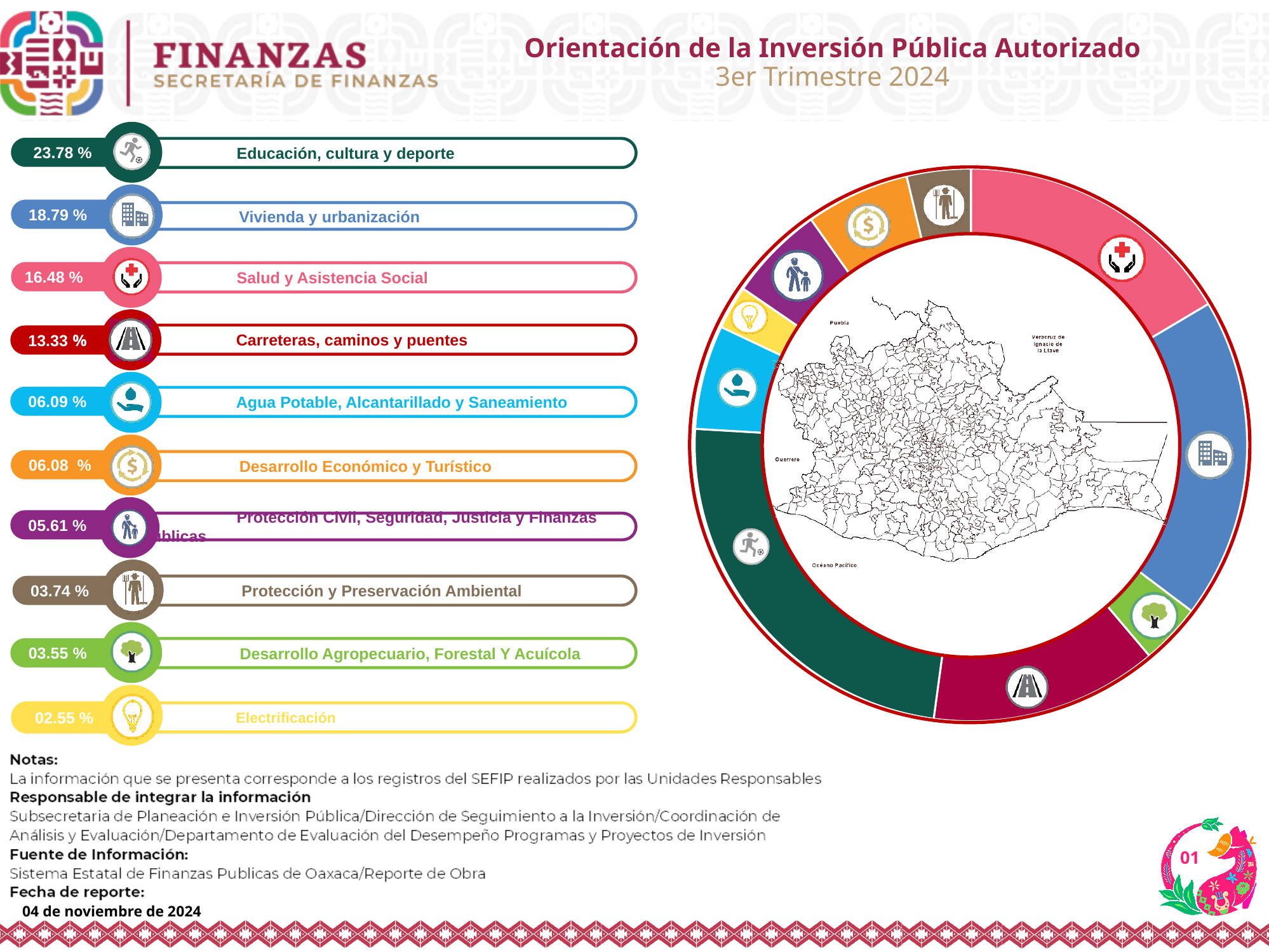
What is the difference in percentage points between Educación, cultura y deporte and Vivienda y urbanización? 4.99 What percentage is shown for Carreteras, caminos y puentes? 13.33 % Which category has the largest share of the chart? Educación, cultura y deporte What percentage is shown for Educación, cultura y deporte? 23.78 % Which has a larger share: Salud y Asistencia Social or Carreteras, caminos y puentes? Salud y Asistencia Social What is the title of the slide containing the chart? Orientación de la Inversión Pública Autorizado 3er Trimestre 2024 Which category has the smallest share of the chart? Electrificación What percentage is shown for Electrificación? 02.55 % What colour represents Agua Potable, Alcantarillado y Saneamiento in the chart? Cyan (light blue) What percentage is shown for Protección y Preservación Ambiental? 03.74 % How many categories are shown in the chart? 10 What kind of chart is shown on the slide? Pie (donut) chart